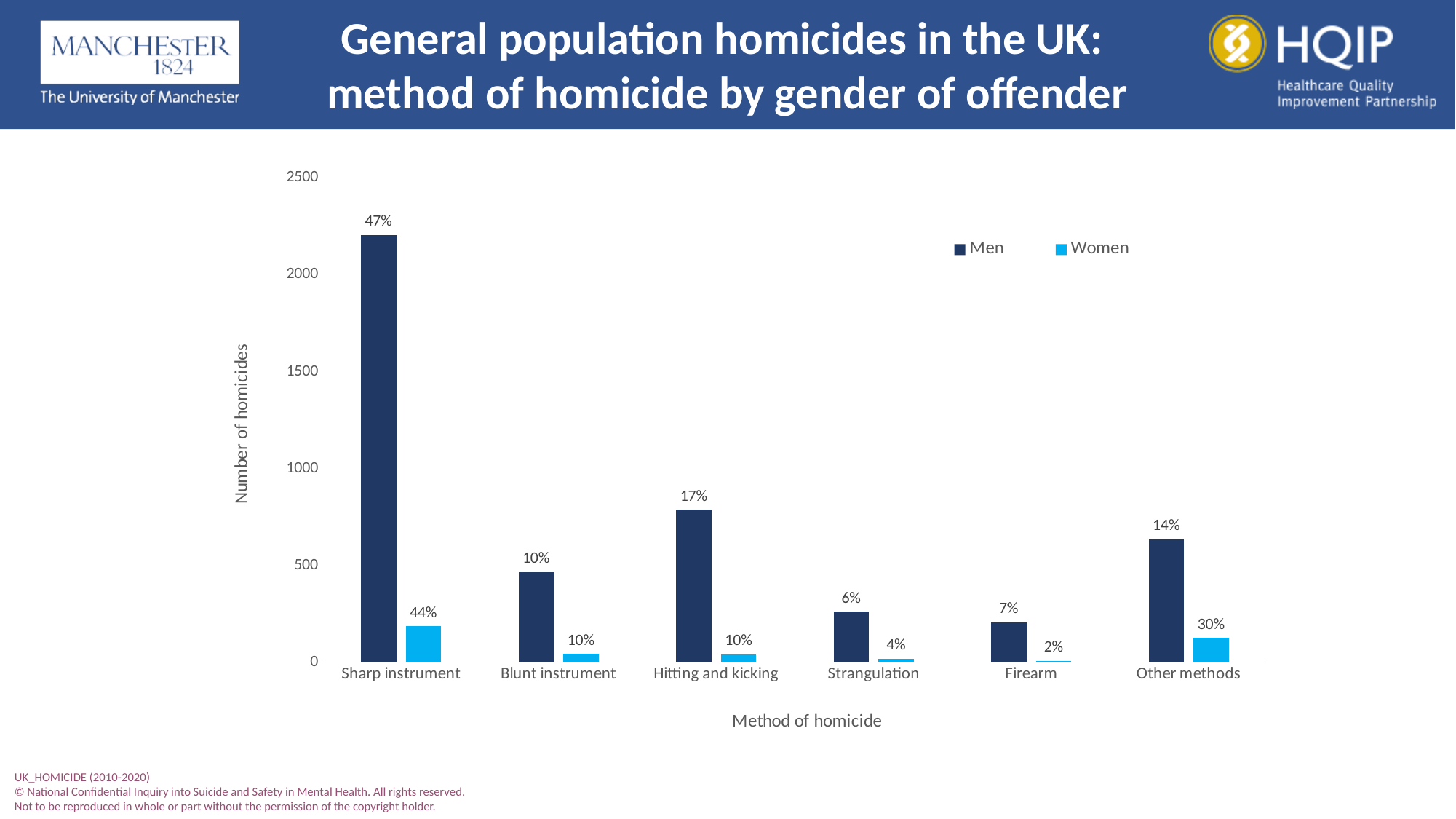
What percentage label is shown on the Women bar for Firearm? 2% What percentage label is shown on the Women bar for Other methods? 30% What percentage label is shown on the Men bar for Hitting and kicking? 17% Is the number of homicides for Men by Sharp instrument greater or less than 2000? greater Which method of homicide has the lowest Women bar? Firearm How many methods of homicide are shown on the x axis? 6 Is the number of homicides for Men by Hitting and kicking greater or less than 1000? less Which method of homicide has the tallest Men bar? Sharp instrument What is the difference in percentage points between the Men and Women labels for Sharp instrument? 3 percentage points For Other methods, which series has the higher percentage label, Men or Women? Women How many series does the legend list? 2 What percentage label is shown on the Men bar for Sharp instrument? 47%